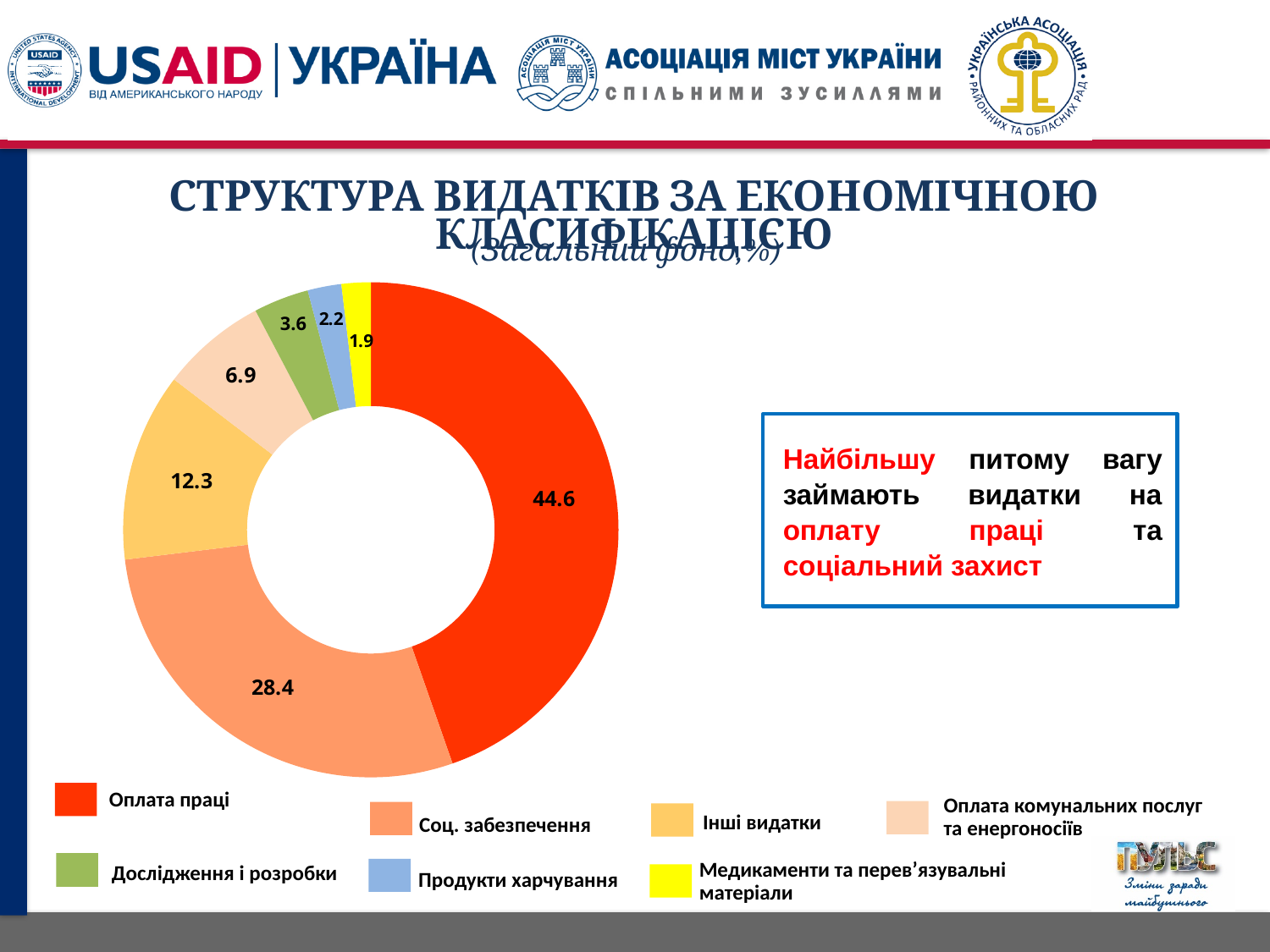
What is the value for Оплата праці? 44.6 What is the value for Продукти харчування? 2.2 What type of chart is shown on the slide? Doughnut chart What is the value for Інші видатки? 12.3 Which category has the largest share of the chart? Оплата праці What is the difference between the values for Оплата праці and Соц. забезпечення? 16.2 What is the value for Оплата комунальних послуг та енергоносіїв? 6.9 Which category has the smallest share of the chart? Медикаменти та перев’язувальні матеріали Which is larger, the value for Дослідження і розробки or the value for Продукти харчування? Дослідження і розробки What colour is the segment for Дослідження і розробки? Green What is the value for Соц. забезпечення? 28.4 How many categories does the legend list? 7